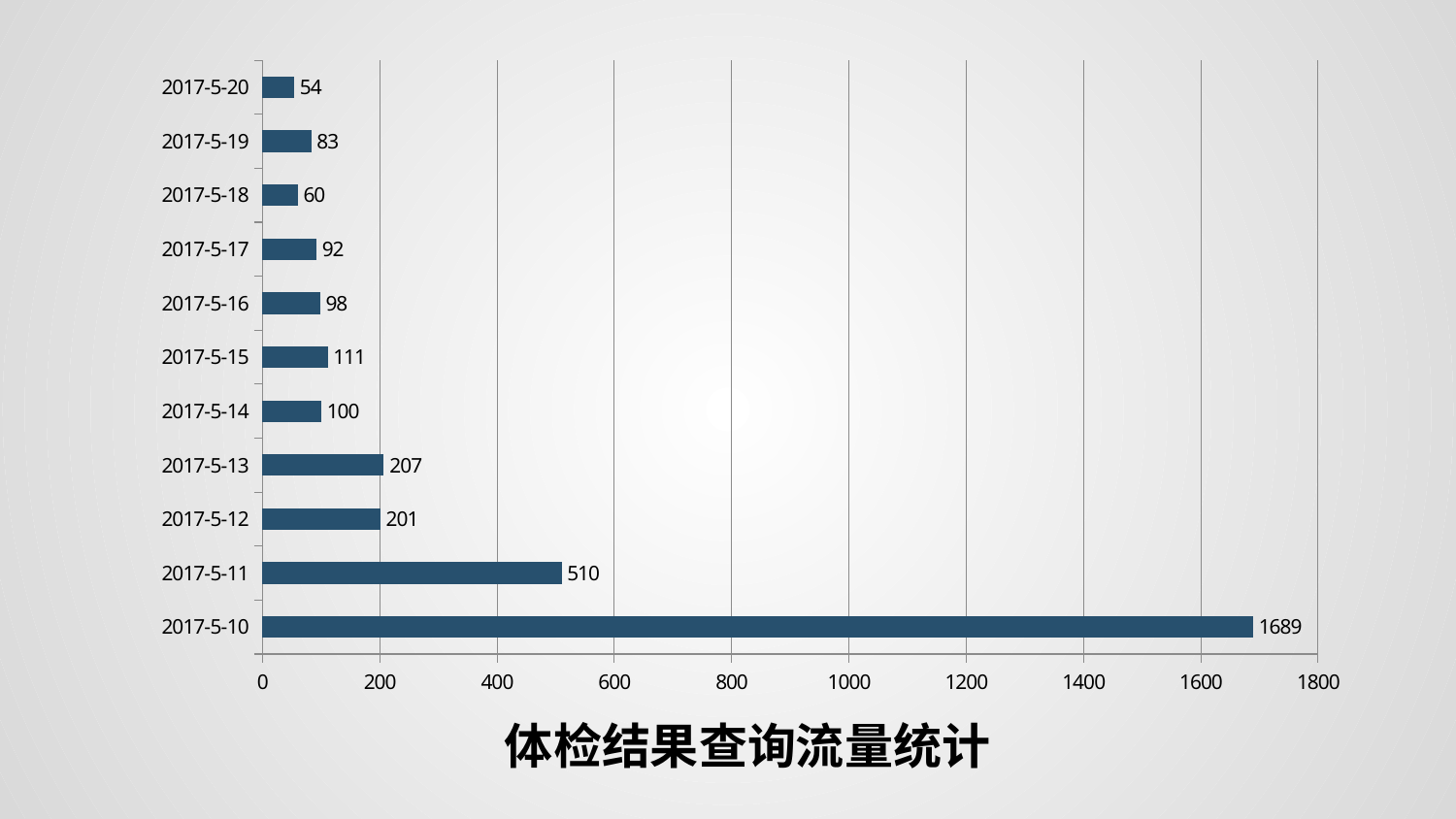
What is the value for 2017-5-15? 111 What kind of chart is shown on the slide? bar chart What is the value for 2017-5-10? 1689 What is the value for 2017-5-20? 54 Which date has the highest value? 2017-5-10 How many dates are shown on the chart? 11 Is the value for 2017-5-11 greater or less than 400? greater Which date has the lowest value? 2017-5-20 Which is larger, the value for 2017-5-17 or the value for 2017-5-18? 2017-5-17 What is the difference between the values for 2017-5-10 and 2017-5-11? 1179 What is the difference between the values for 2017-5-13 and 2017-5-12? 6 What is the title of the chart? 体检结果查询流量统计